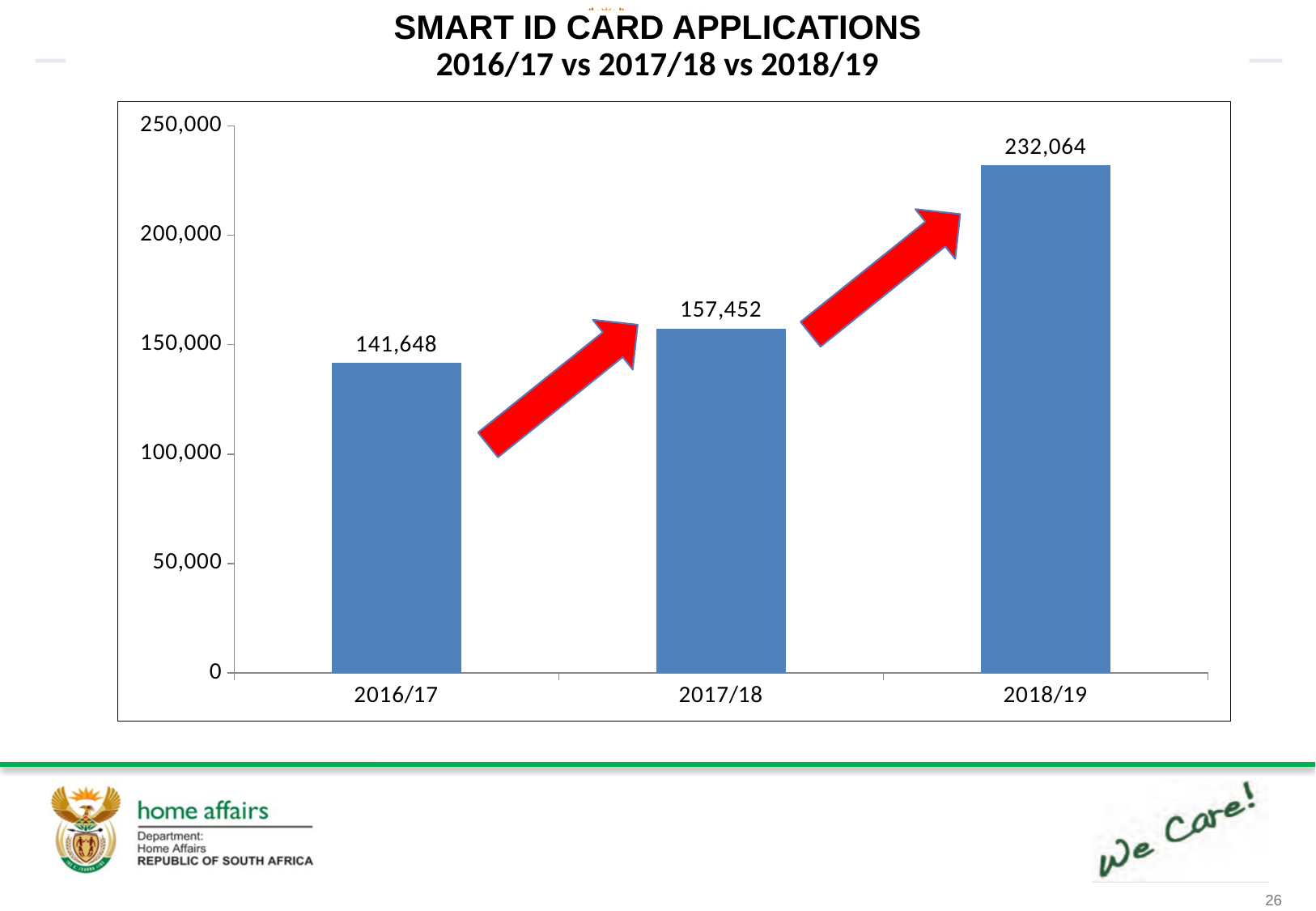
What is the difference in Smart ID card applications between 2017/18 and 2016/17? 15,804 How many years are shown on the chart? 3 What is the number of Smart ID card applications for 2018/19? 232,064 Which year has the highest number of Smart ID card applications? 2018/19 What kind of chart is shown on the slide? Bar chart What is the number of Smart ID card applications for 2017/18? 157,452 Do Smart ID card applications rise or fall from 2016/17 to 2018/19? Rise What is the difference in Smart ID card applications between 2018/19 and 2017/18? 74,612 Which year has the lowest number of Smart ID card applications? 2016/17 Is the value for 2018/19 greater or less than 200,000? greater What is the number of Smart ID card applications for 2016/17? 141,648 Which year had more Smart ID card applications, 2016/17 or 2017/18? 2017/18